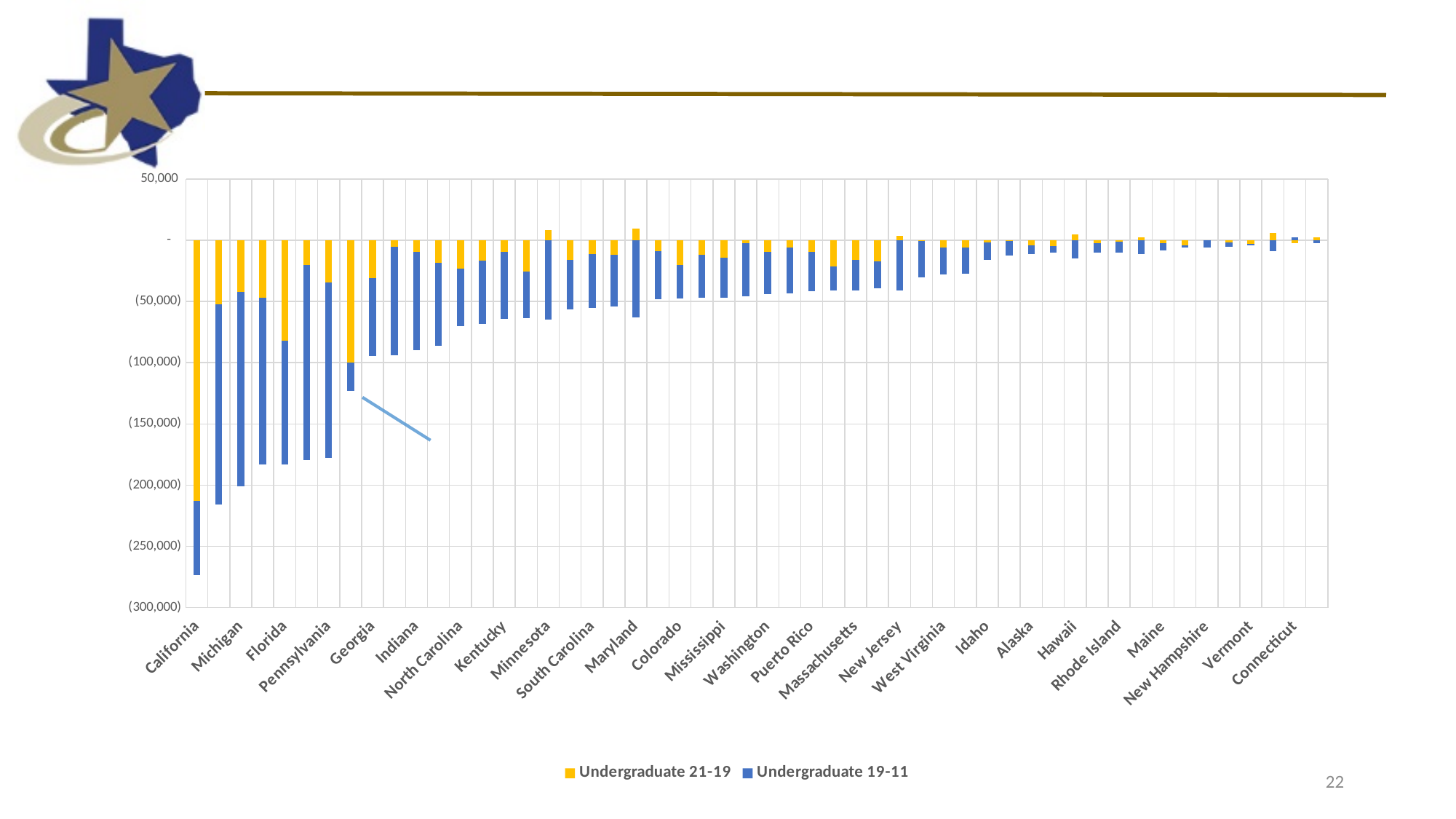
What are the two series named in the legend? Undergraduate 21-19 and Undergraduate 19-11 What kind of chart is shown on the slide? bar chart Is the bottom of the stacked bar for California greater or less than (250,000)? less Moving from left to right along the x axis, do the stacked bar totals rise or fall? rise Which colour represents the Undergraduate 21-19 series? yellow Which state's stacked bar extends furthest below zero? California How many series does the legend list? 2 Which state's stacked bar extends further below zero, California or Georgia? California Is the bottom of the stacked bar for Kentucky greater or less than (50,000)? less Is the bottom of the stacked bar for Indiana greater or less than (100,000)? greater